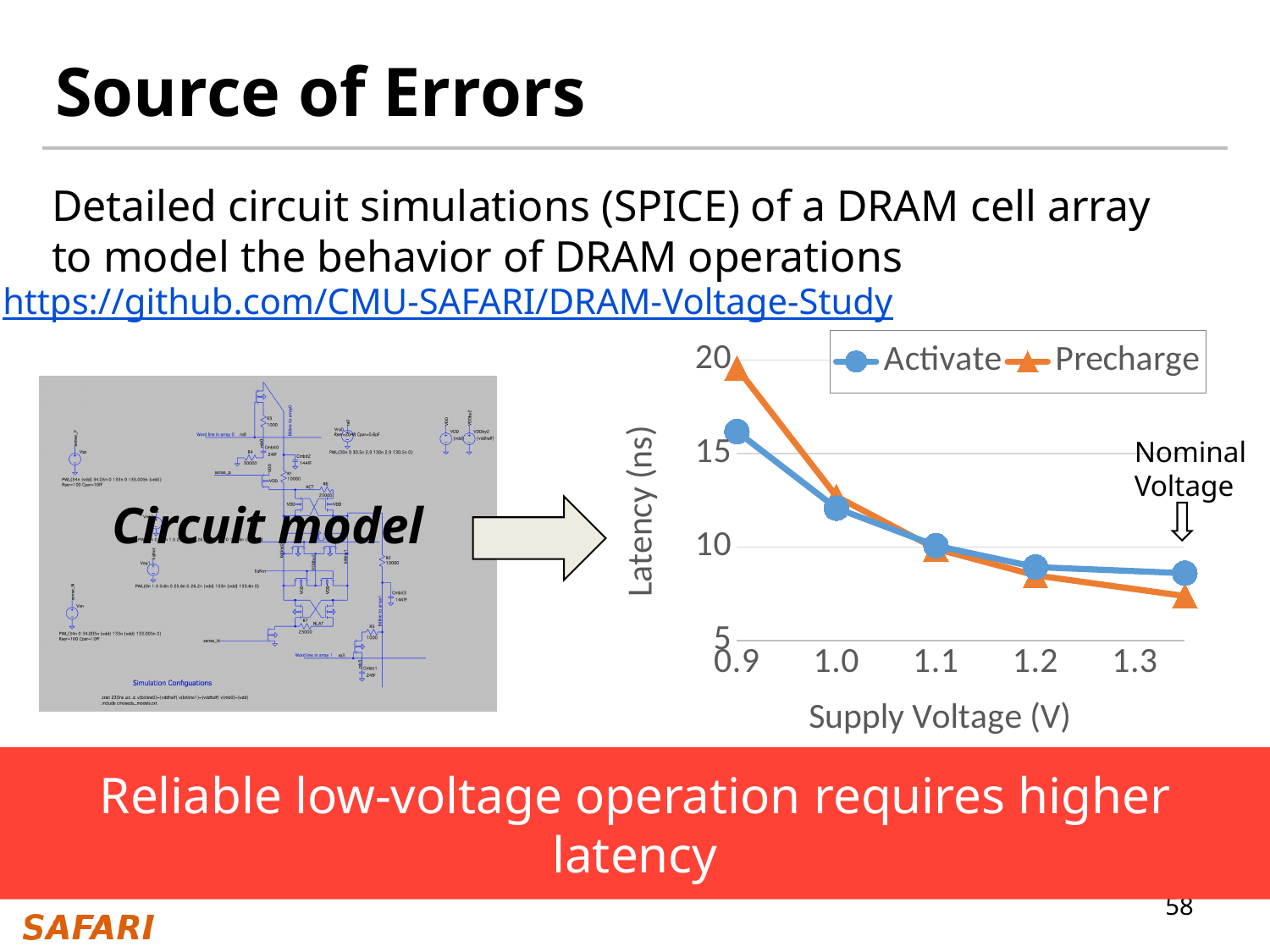
Is the Precharge latency at 1.2 V greater or less than 10 ns? less What kind of chart is shown on the slide? line chart Is the Precharge latency at 0.9 V greater or less than 15 ns? greater At which supply voltage is the Precharge latency highest? 0.9 At 0.9 V, which series has the higher latency, Activate or Precharge? Precharge What is the label of the chart's x axis? Supply Voltage (V) Is the Activate latency at 0.9 V greater or less than 15 ns? greater At the highest supply voltage plotted, which series has the lower latency, Activate or Precharge? Precharge How many series does the chart's legend list? 2 What are the two series named in the chart's legend? Activate and Precharge Does latency rise or fall as supply voltage increases along the x axis? fall